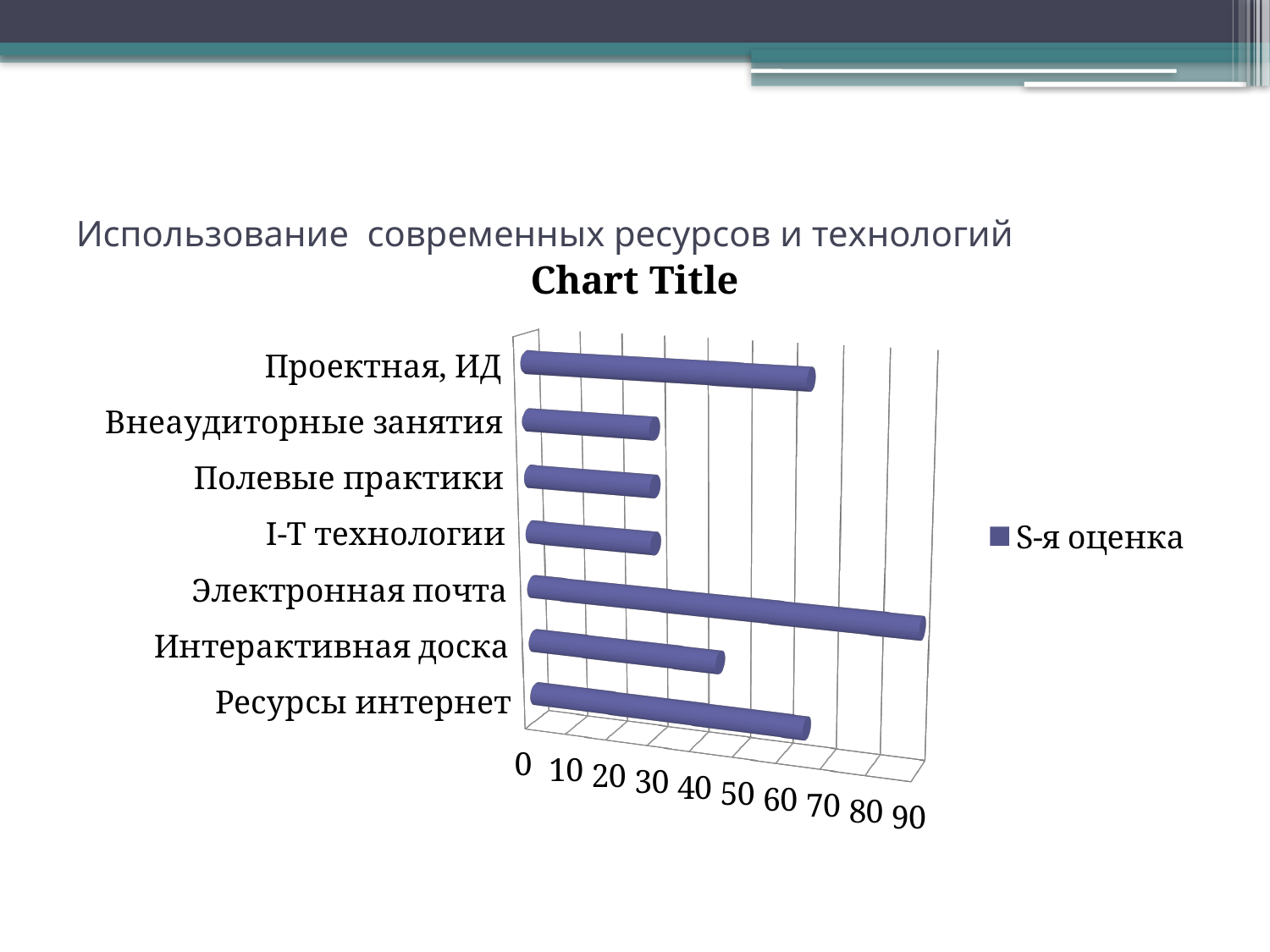
What series name is shown in the chart legend? S-я оценка Which is larger, the value for Проектная, ИД or the value for Внеаудиторные занятия? Проектная, ИД What is the title shown above the chart? Chart Title Is the value for Внеаудиторные занятия greater or less than 50? less Which is larger, the value for Электронная почта or the value for Интерактивная доска? Электронная почта Which category has the highest value in the chart? Электронная почта Is the value for Электронная почта greater or less than 70? greater How many series does the chart legend list? 1 Is the value for Интерактивная доска greater or less than 60? less What kind of chart is shown on the slide? bar chart How many categories are plotted in the chart? 7